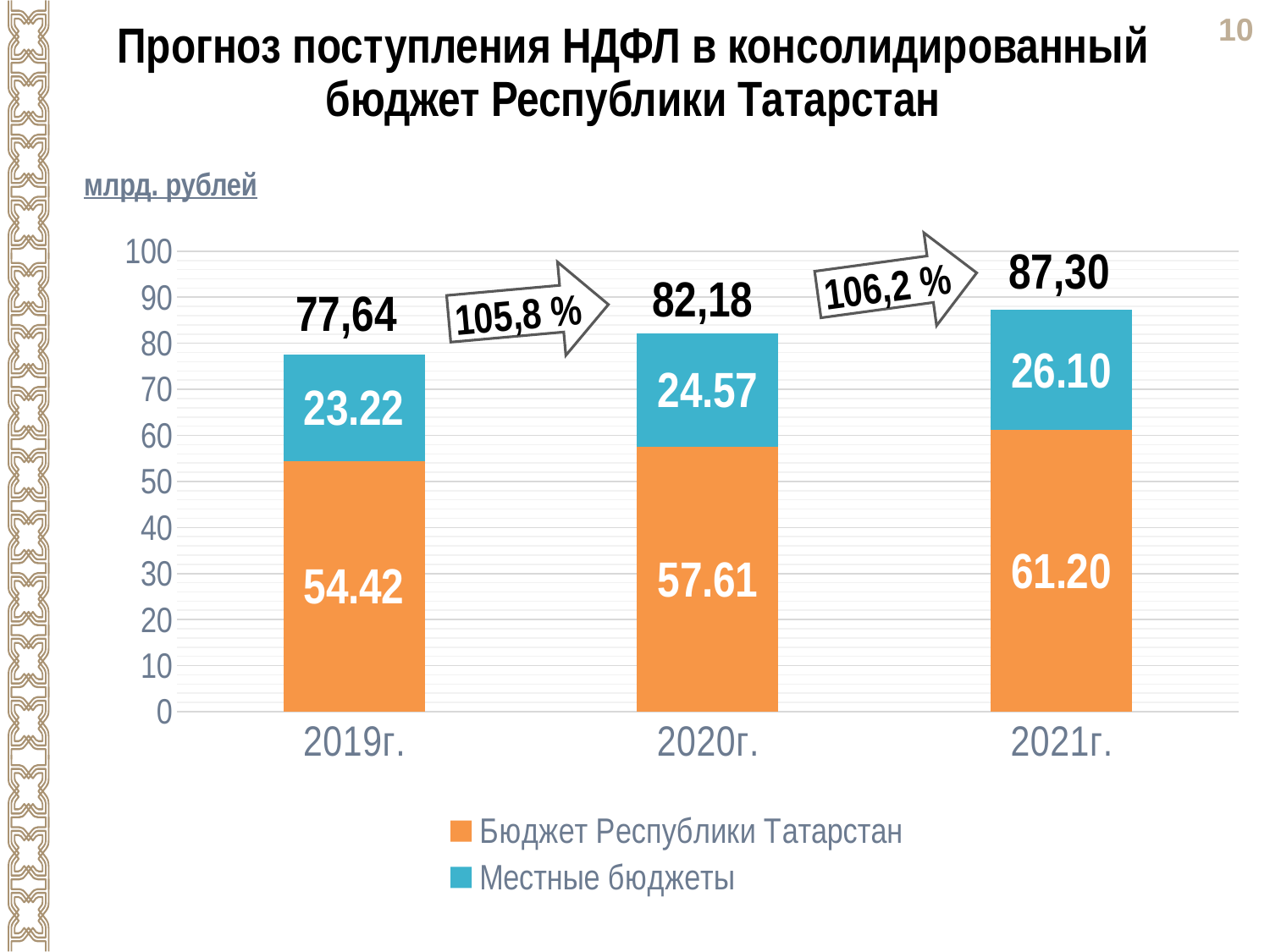
Which is larger: Местные бюджеты in 2020г. or Местные бюджеты in 2019г.? Местные бюджеты in 2020г. What is the value for Местные бюджеты in 2021г.? 26.10 What is the difference between the Бюджет Республики Татарстан values for 2021г. and 2020г.? 3.59 What is the value for Бюджет Республики Татарстан in 2019г.? 54.42 Do the stacked bar totals rise or fall from 2019г. to 2021г.? rise Which year has the lowest value for Местные бюджеты? 2019г. How many years are shown on the x axis? 3 What is the total of the stacked bar for 2021г.? 87,30 What is the total of the stacked bar for 2019г.? 77,64 Which year has the highest value for Бюджет Республики Татарстан? 2021г. What is the value for Местные бюджеты in 2020г.? 24.57 How many series does the legend list? 2